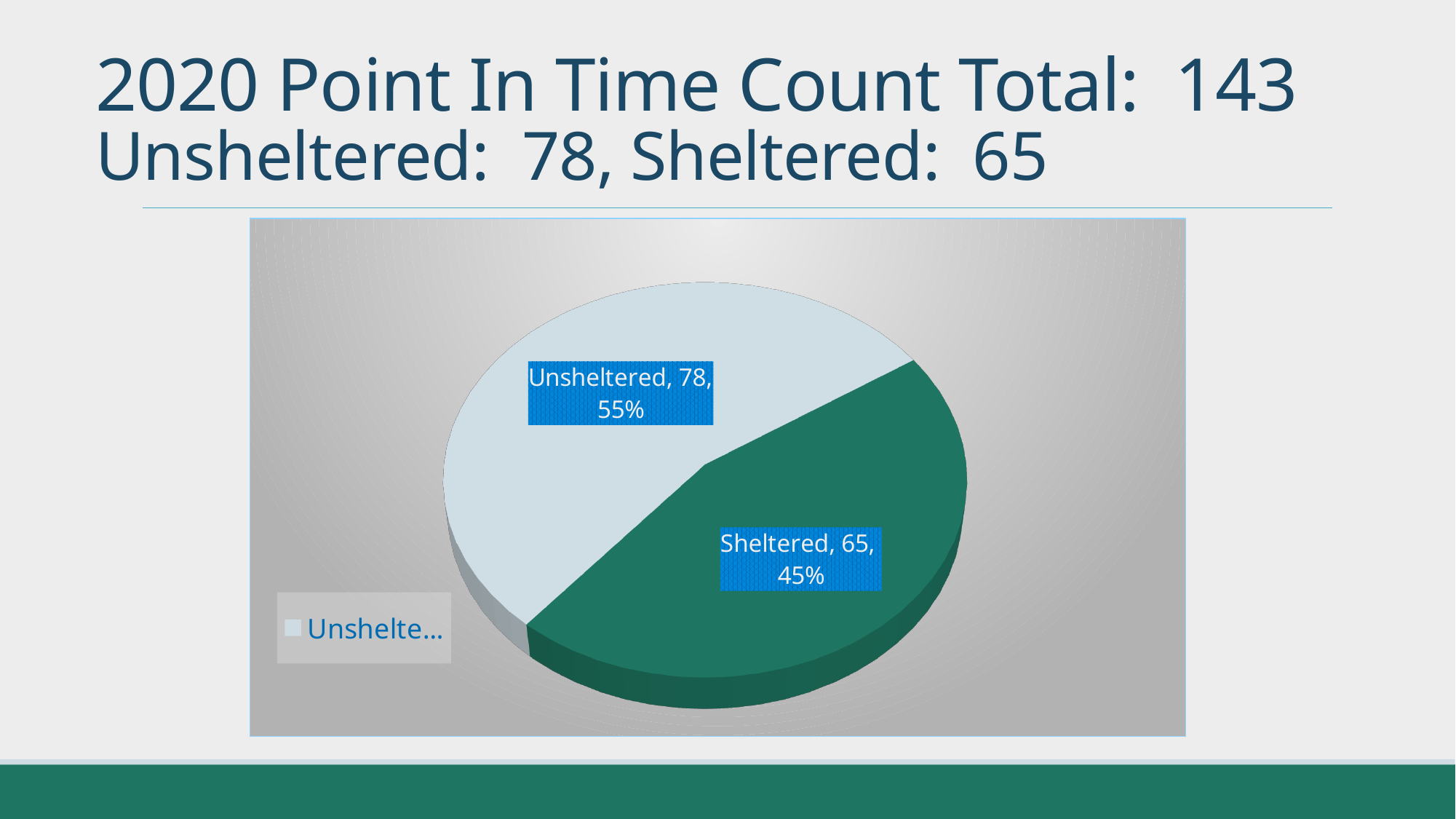
What is the difference between the Unsheltered and Sheltered values? 13 Which category has the smallest slice? Sheltered What is the value for Sheltered? 65 What kind of chart is shown on the slide? pie chart Which category has the largest slice? Unsheltered Which is larger, Unsheltered or Sheltered? Unsheltered What is the total of the two slices in the pie chart? 143 What share of the pie does the Unsheltered slice represent? 55% What is the value for Unsheltered? 78 How many slices does the pie chart have? 2 What share of the pie does the Sheltered slice represent? 45% What colour is the Sheltered slice? green